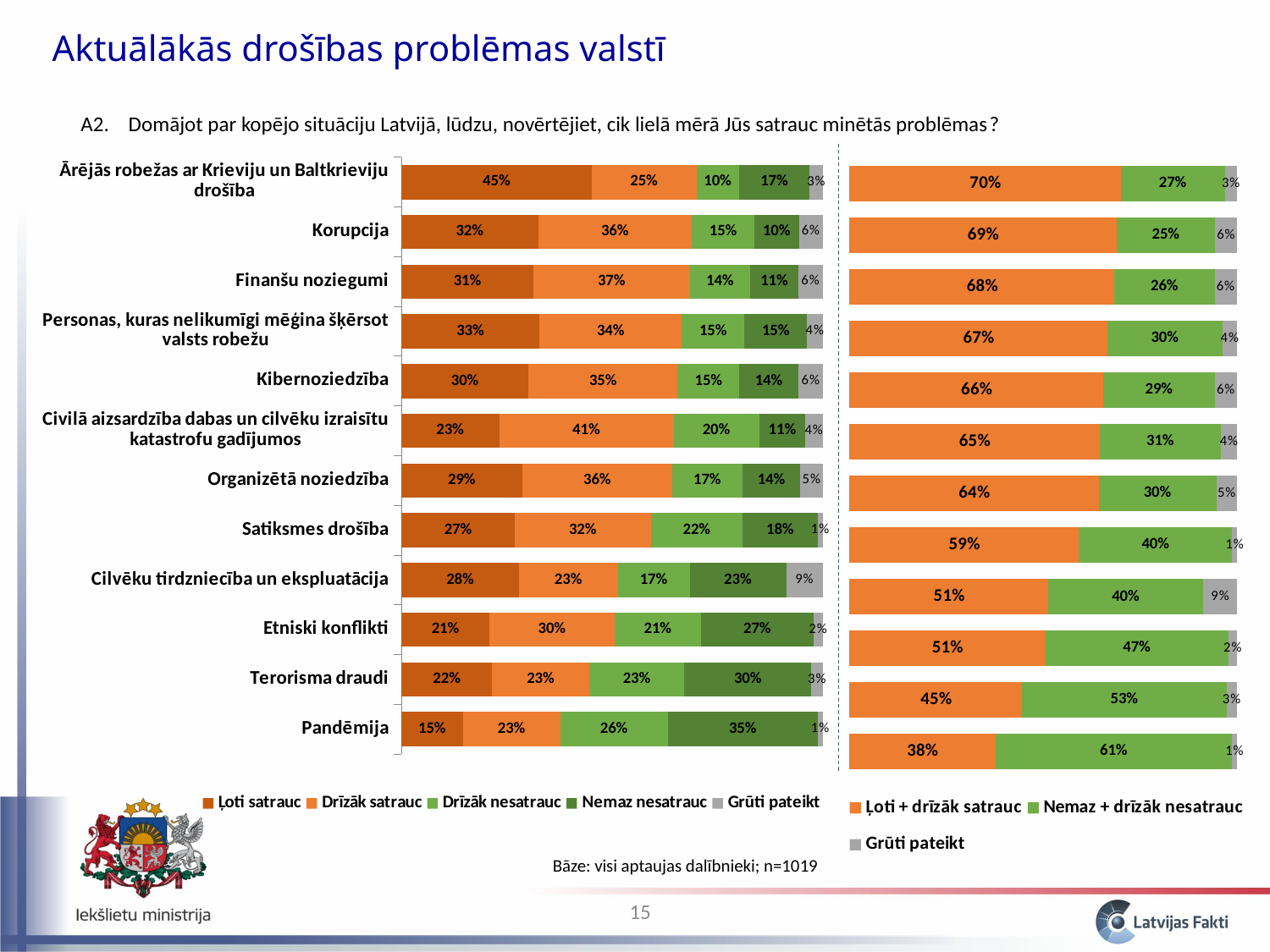
In the left chart, what is the 'Grūti pateikt' value for Cilvēku tirdzniecība un ekspluatācija? 9% In the left chart, what is the 'Ļoti satrauc' value for Korupcija? 32% In the right chart, what is the 'Nemaz + drīzāk nesatrauc' value for Terorisma draudi? 53% How many series does the legend of the right chart list? 3 In the right chart, which category has the lowest 'Ļoti + drīzāk satrauc' value? Pandēmija How many series does the legend of the left chart list? 5 In the left chart, what is the difference between the 'Nemaz nesatrauc' values for Pandēmija and Terorisma draudi? 5% In the right chart, what is the 'Ļoti + drīzāk satrauc' value for Pandēmija? 38% In the right chart, which is larger for Etniski konflikti: 'Ļoti + drīzāk satrauc' or 'Nemaz + drīzāk nesatrauc'? Ļoti + drīzāk satrauc In the left chart, which category has the highest 'Ļoti satrauc' value? Ārējās robežas ar Krieviju un Baltkrieviju drošība How many categories are shown in the left chart? 12 What kind of chart is the right chart? Stacked bar chart